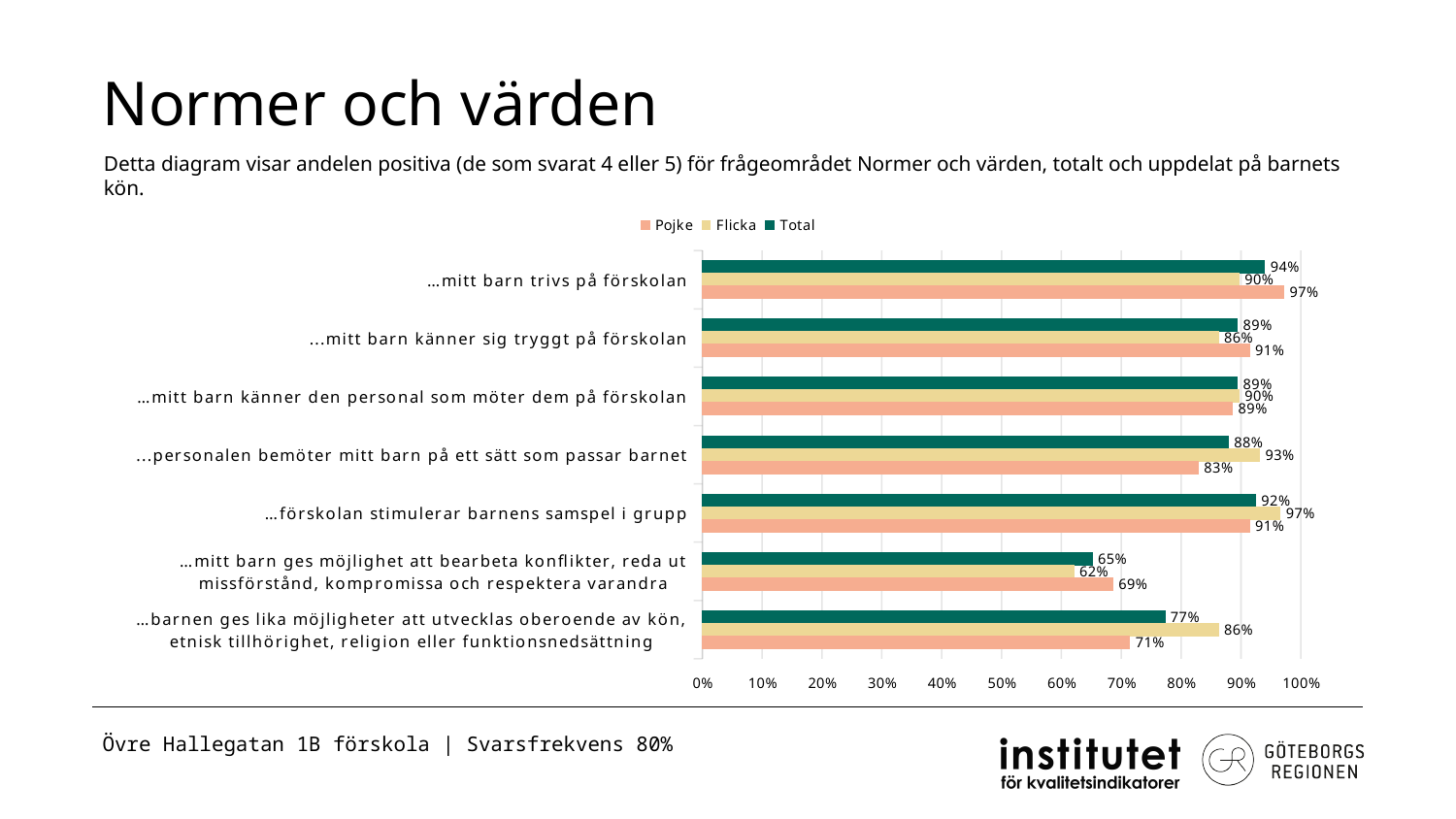
What is the Total value for "…mitt barn trivs på förskolan"? 94% How many series does the legend list? 3 What is the difference between the Flicka and Pojke values for "…barnen ges lika möjligheter att utvecklas oberoende av kön, etnisk tillhörighet, religion eller funktionsnedsättning"? 15% Which series is shown in green in the legend? Total Which category has the lowest Total value? …mitt barn ges möjlighet att bearbeta konflikter, reda ut missförstånd, kompromissa och respektera varandra For "...mitt barn känner sig tryggt på förskolan", which is larger, the Pojke value or the Flicka value? Pojke Is the Total value for "…mitt barn ges möjlighet att bearbeta konflikter, reda ut missförstånd, kompromissa och respektera varandra" greater or less than 70%? less How many categories are plotted in the chart? 7 Which category has the highest Total value? …mitt barn trivs på förskolan What kind of chart is shown on the slide? bar chart What is the Pojke value for "...personalen bemöter mitt barn på ett sätt som passar barnet"? 83% What is the Flicka value for "…förskolan stimulerar barnens samspel i grupp"? 97%